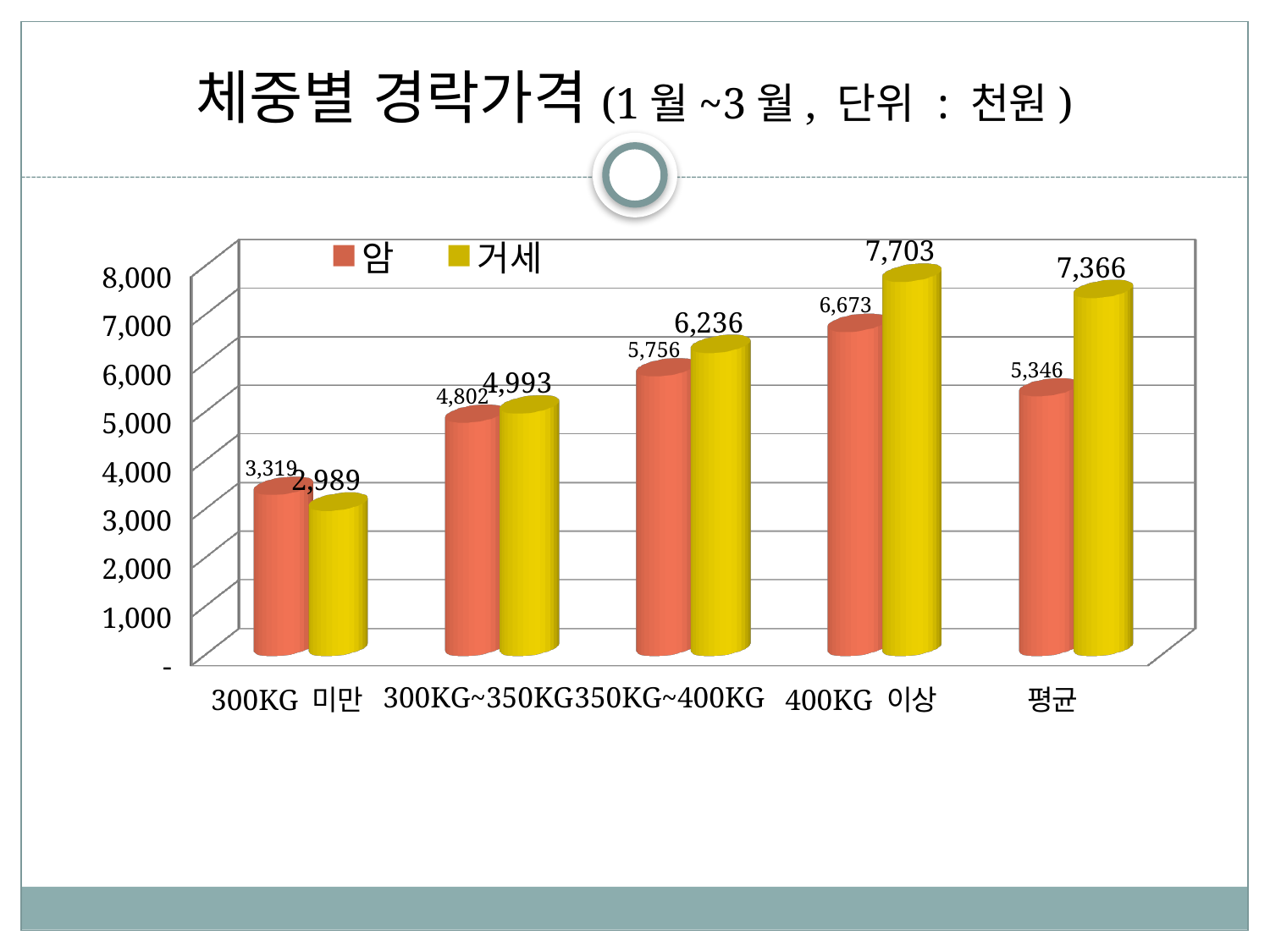
What is the value for 암 in the 350KG~400KG category? 5,756 What kind of chart is shown on the slide? Bar chart Which category has the highest value for 거세? 400KG 이상 In the 300KG 미만 category, which series has the larger value, 암 or 거세? 암 What is the value for 거세 in the 400KG 이상 category? 7,703 Which category has the lowest value for 암? 300KG 미만 Is the value for 거세 in the 300KG~350KG category greater or less than 4,000? greater What is the value for 거세 in the 평균 category? 7,366 What is the difference between 거세 and 암 in the 400KG 이상 category? 1,030 How many series does the legend list? 2 What is the value for 암 in the 300KG 미만 category? 3,319 How many categories are shown on the x axis? 5